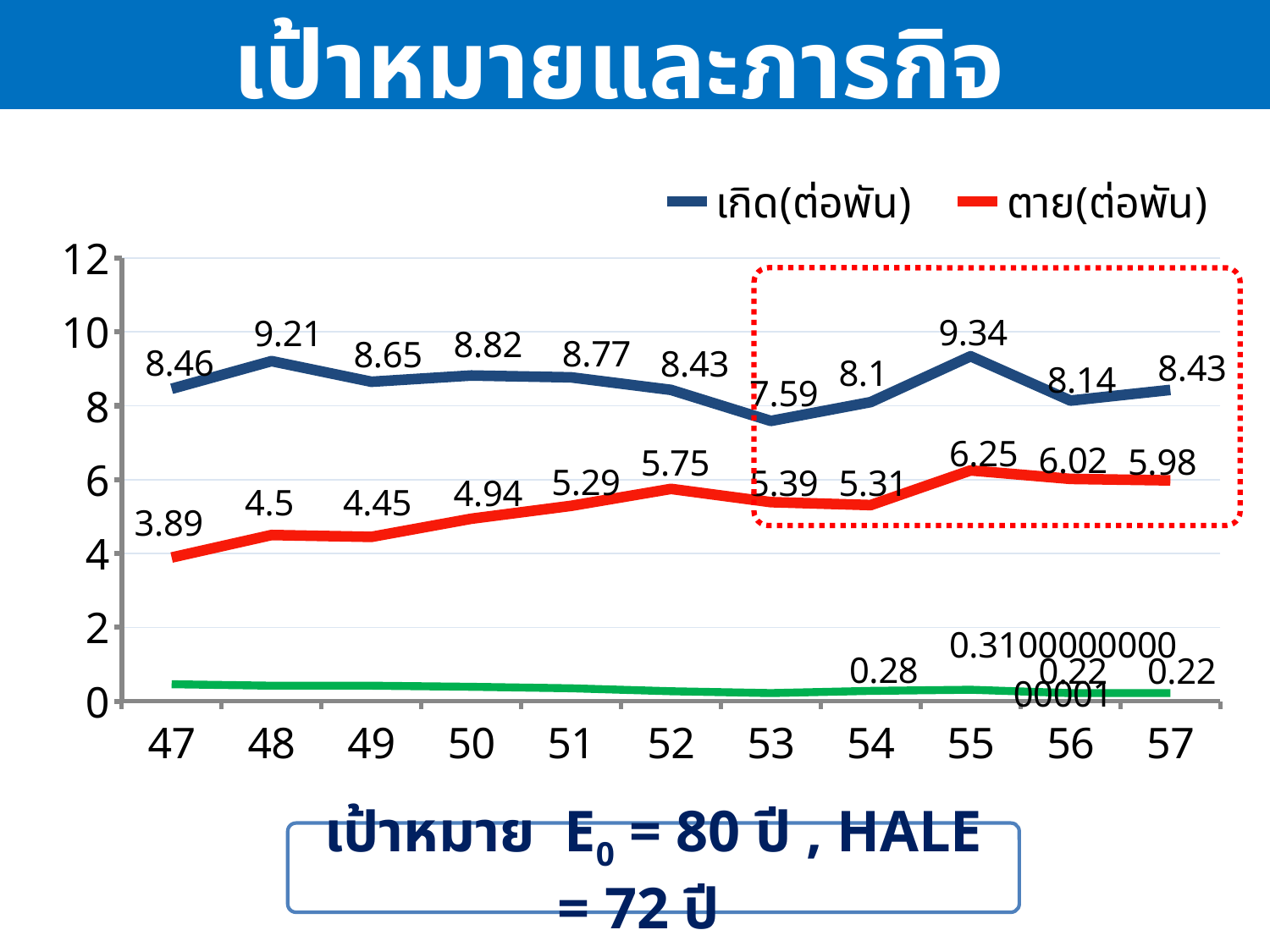
In which year is ตาย(ต่อพัน) highest? 55 What is the value of เกิด(ต่อพัน) at 48? 9.21 What kind of chart is shown on the slide? line chart What is the value of ตาย(ต่อพัน) at 52? 5.75 Is ตาย(ต่อพัน) larger at 52 or at 53? 52 In which year is เกิด(ต่อพัน) lowest? 53 In which year is เกิด(ต่อพัน) highest? 55 How many years are shown on the x axis? 11 What is the value of เกิด(ต่อพัน) at 53? 7.59 In which year is ตาย(ต่อพัน) lowest? 47 How many series does the legend list? 2 What is the difference between เกิด(ต่อพัน) and ตาย(ต่อพัน) at 57? 2.45